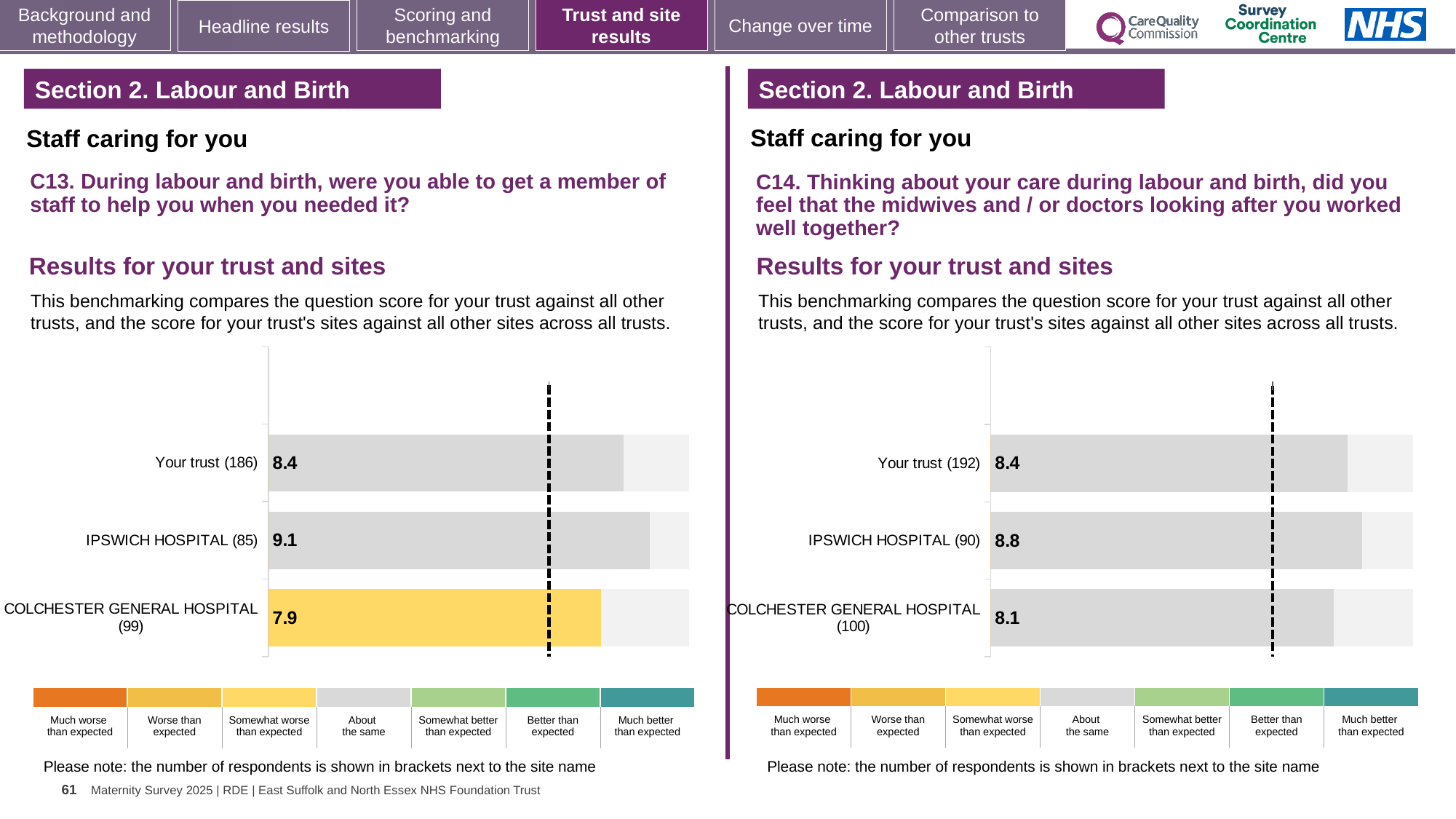
In the C13 chart on the left, which site or trust has the highest score? IPSWICH HOSPITAL In the C14 chart on the right, is the score for IPSWICH HOSPITAL higher or lower than the score for Your trust? higher In the C14 chart on the right, what is the score for COLCHESTER GENERAL HOSPITAL? 8.1 In the C14 chart on the right, what is the difference between the scores for IPSWICH HOSPITAL and Your trust? 0.4 In the C13 chart on the left, which bar is coloured yellow rather than grey? COLCHESTER GENERAL HOSPITAL In the C13 chart on the left, how many bars are plotted? 3 In the C14 chart on the right, what is the score for Your trust? 8.4 In the C13 chart on the left, what is the score for IPSWICH HOSPITAL? 9.1 What type of chart is used on the right-hand side of the slide for C14? bar chart In the C14 chart on the right, which site or trust has the lowest score? COLCHESTER GENERAL HOSPITAL In the C13 chart on the left, what is the difference between the scores for IPSWICH HOSPITAL and COLCHESTER GENERAL HOSPITAL? 1.2 In the C13 chart on the left, what is the score for COLCHESTER GENERAL HOSPITAL? 7.9